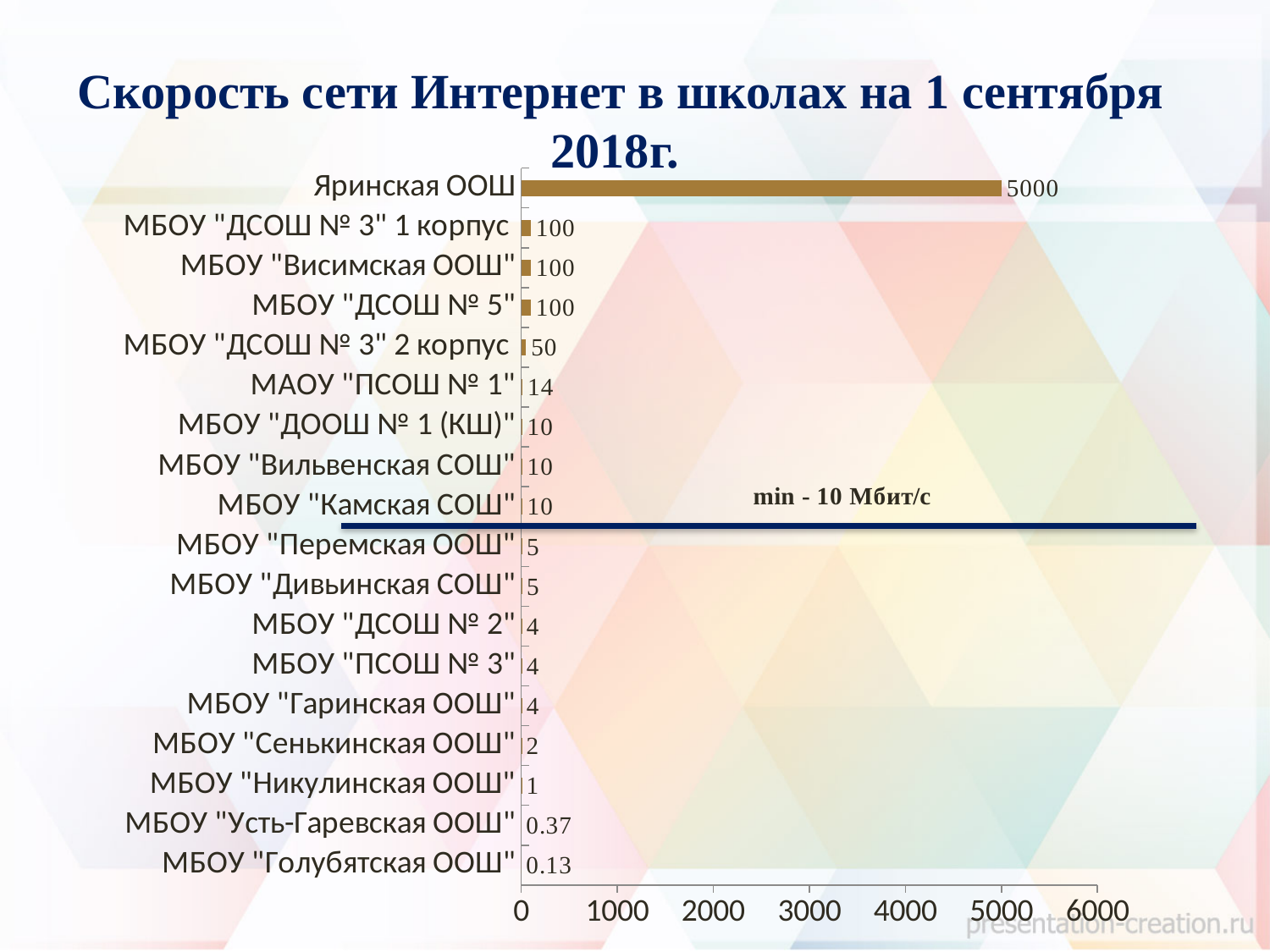
What is the value for МБОУ "ДСОШ № 3" 2 корпус? 50 What type of chart is shown on the slide? bar chart Which school has the highest value? Яринская ООШ What minimum speed is indicated by the horizontal line label on the chart? min - 10 Мбит/с What is the difference between the values for Яринская ООШ and МБОУ "ДСОШ № 5"? 4900 Which school has the lowest value? МБОУ "Голубятская ООШ" How many schools are shown in the chart? 18 What is the value for МАОУ "ПСОШ № 1"? 14 What is the value for Яринская ООШ? 5000 Which is larger, the value for МБОУ "Сенькинская ООШ" or the value for МБОУ "Никулинская ООШ"? МБОУ "Сенькинская ООШ" Is the value for Яринская ООШ greater or less than 4000? greater What is the value for МБОУ "Усть-Гаревская ООШ"? 0.37